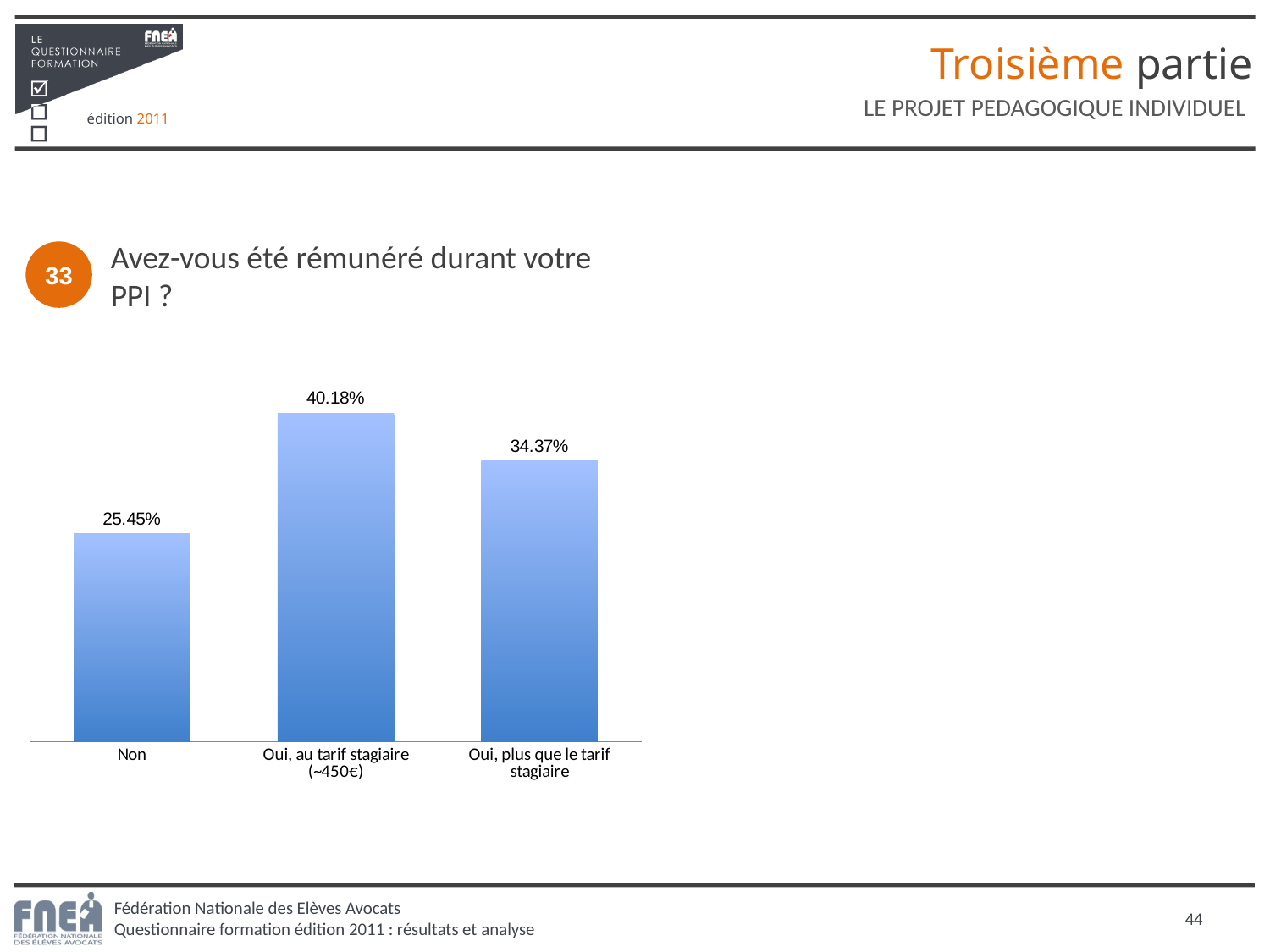
Which category has the lowest value? Non What is the value for "Oui, plus que le tarif stagiaire"? 34.37% Which is larger: the value for "Non" or the value for "Oui, plus que le tarif stagiaire"? Oui, plus que le tarif stagiaire What is the difference between "Oui, au tarif stagiaire (~450€)" and "Oui, plus que le tarif stagiaire"? 5.81% What question does the chart answer? Avez-vous été rémunéré durant votre PPI ? Which category has the highest value? Oui, au tarif stagiaire (~450€) How many categories are shown in the chart? 3 What is the value for "Oui, au tarif stagiaire (~450€)"? 40.18% What is the difference between "Oui, plus que le tarif stagiaire" and "Non"? 8.92% What kind of chart is shown on the slide? Bar chart What percentage of respondents answered "Non"? 25.45% What is the question number shown next to the chart's question? 33